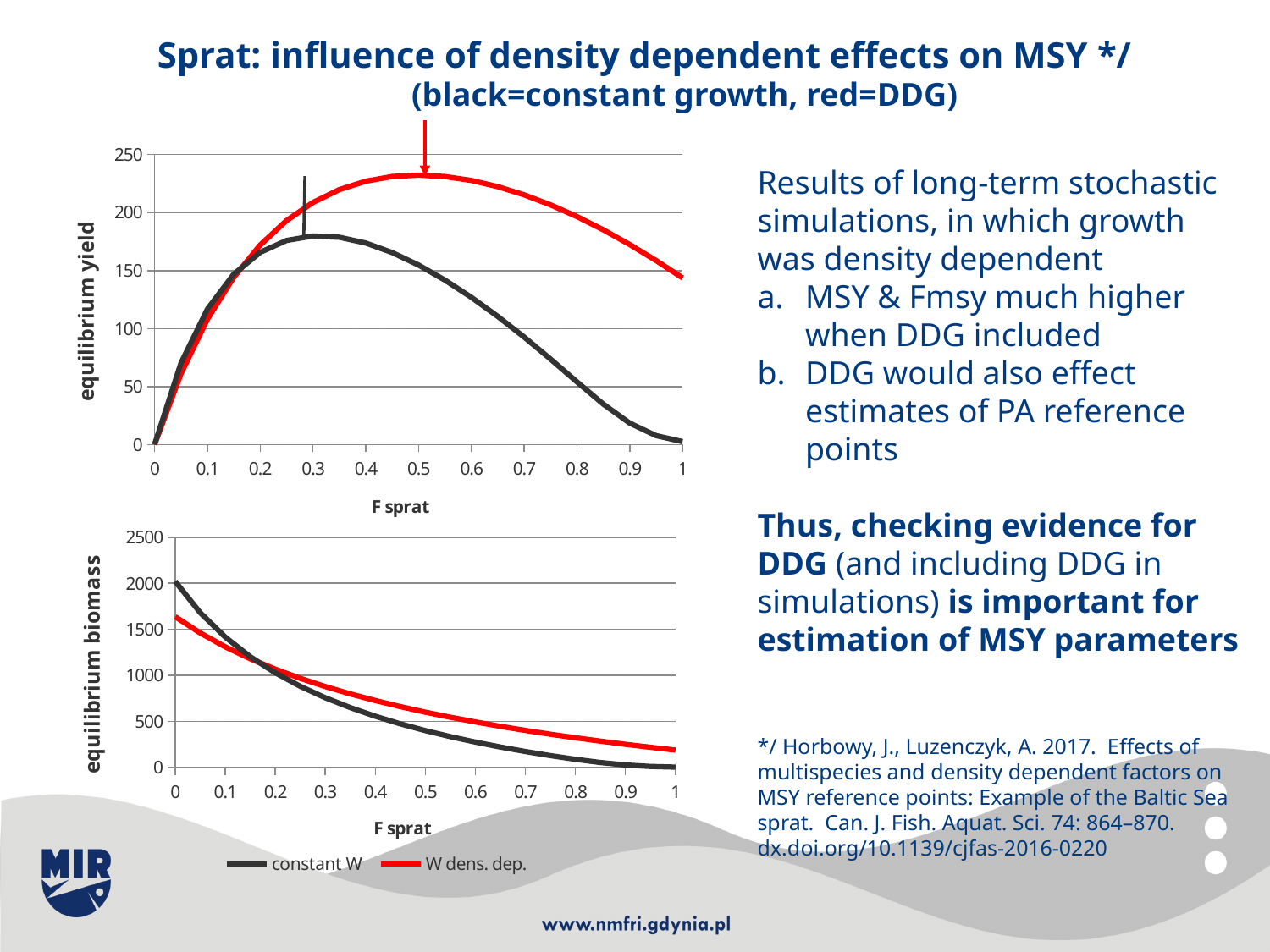
What kind of chart is the top chart (equilibrium yield vs F sprat)? line chart In the legend, which series is drawn in red? W dens. dep. In the top chart (equilibrium yield), at F sprat = 0.5, which line is higher, the black constant W line or the red W dens. dep. line? W dens. dep. What is the x-axis title of the top chart? F sprat In the bottom chart (equilibrium biomass), do the values of both lines rise or fall as F sprat increases from 0 to 1? fall What kind of chart is the bottom chart (equilibrium biomass vs F sprat)? line chart In the bottom chart (equilibrium biomass), at F sprat = 0, which line is higher, constant W or W dens. dep.? constant W How many series does the legend at the bottom of the slide list? 2 In the top chart (equilibrium yield), which series reaches the higher peak yield, constant W or W dens. dep.? W dens. dep. In the top chart (equilibrium yield), is the value of the red W dens. dep. line at F sprat = 0.5 greater or less than 200? greater In the top chart (equilibrium yield), is the value of the black constant W line at F sprat = 0.9 greater or less than 50? less In the bottom chart (equilibrium biomass), is the value of the black constant W line at F sprat = 0.5 greater or less than 500? less